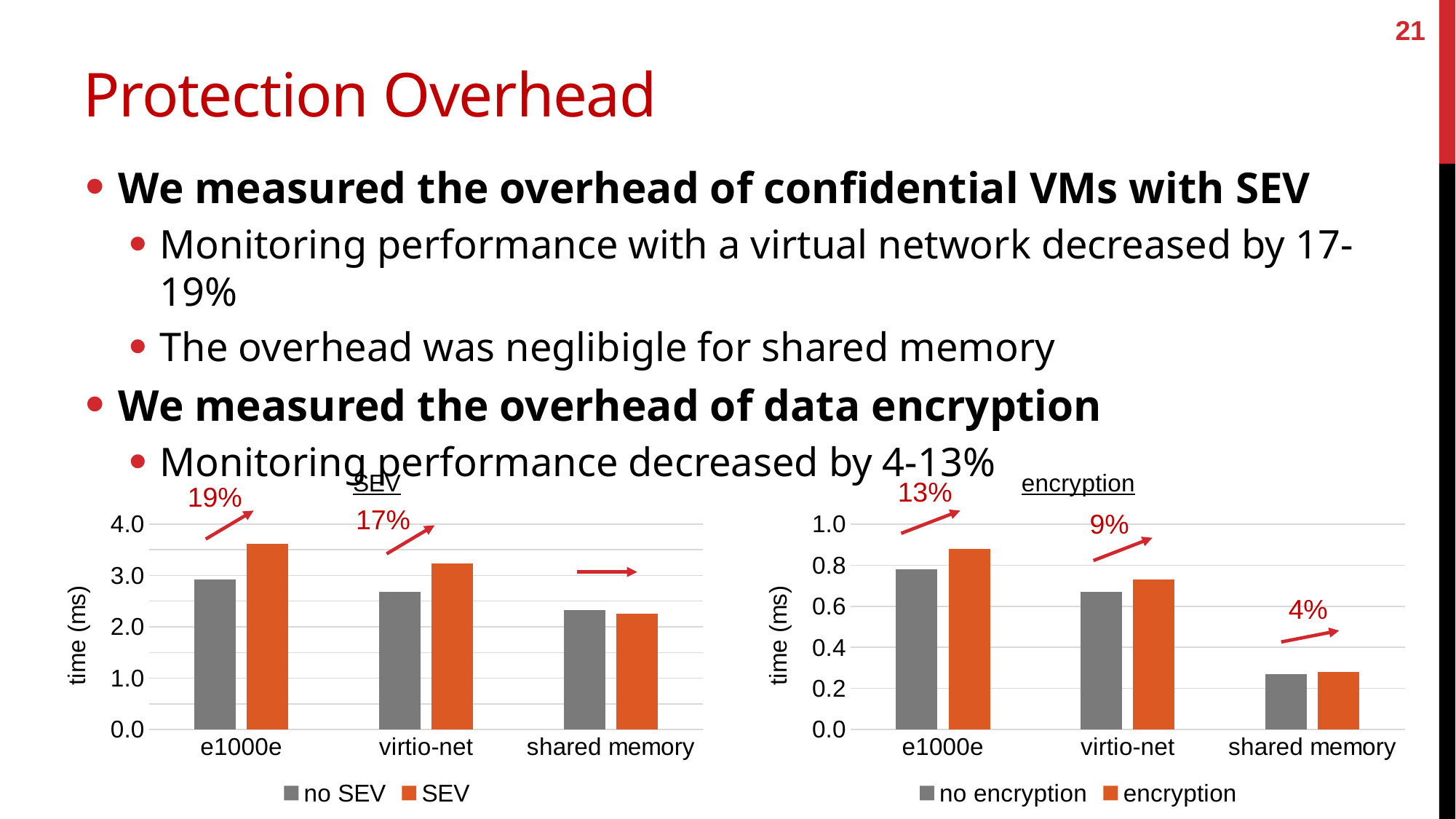
In the SEV chart, is the SEV value for e1000e greater or less than 3.0? greater What is the y-axis label of the encryption chart? time (ms) In the SEV chart, do the no SEV values rise or fall from e1000e to shared memory? fall How many series does the legend of the encryption chart on the right list? 2 In the SEV chart, is the no SEV value for shared memory greater or less than 3.0? less In the SEV chart, which category has the highest SEV bar? e1000e How many categories are shown on the x axis of the SEV chart? 3 In the encryption chart, is the no encryption value for virtio-net greater or less than 0.8? less In the encryption chart, which is larger for e1000e: the no encryption bar or the encryption bar? encryption In the encryption chart, which category has the lowest no encryption bar? shared memory What kind of chart is the SEV chart on the left? bar chart